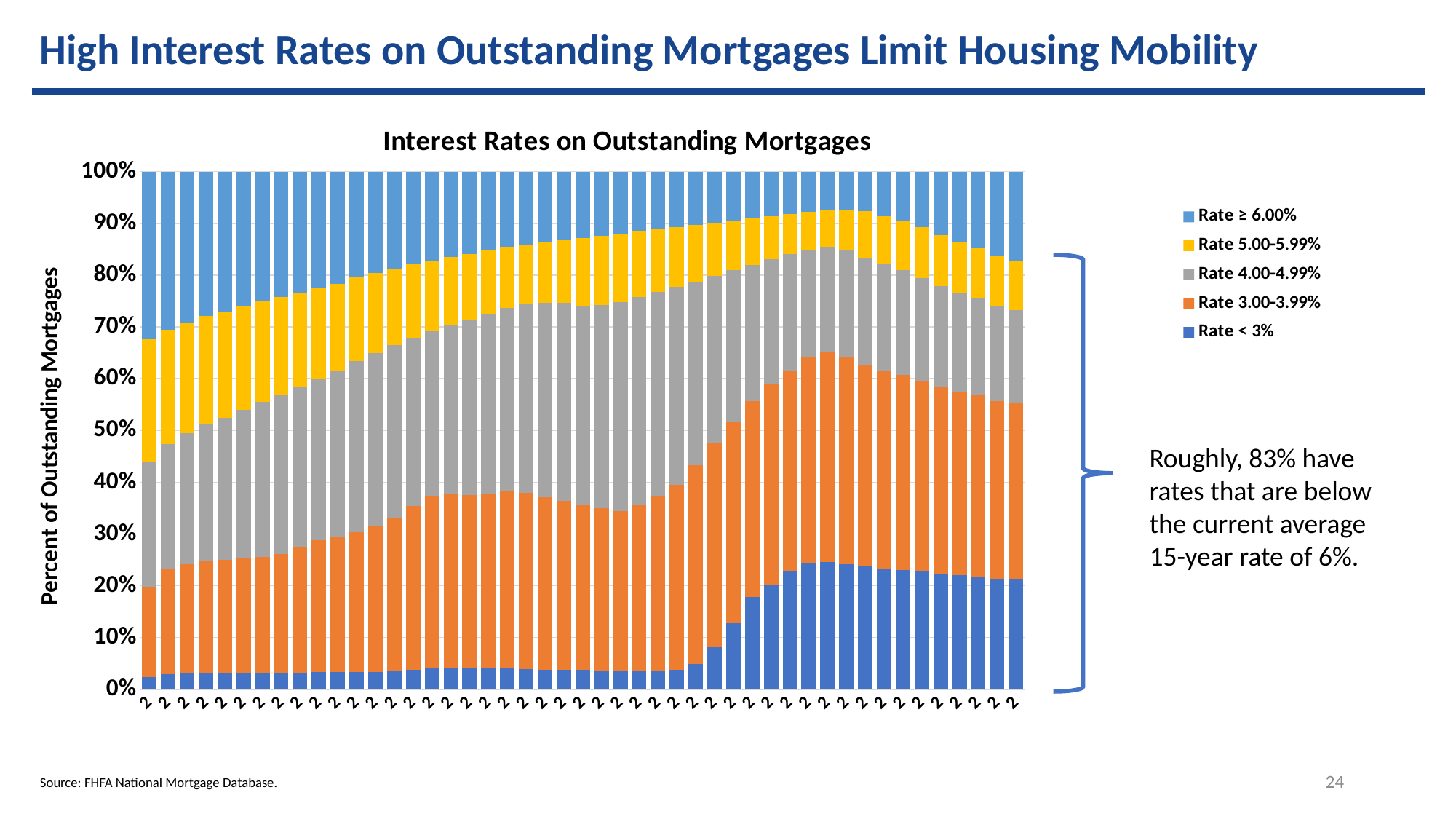
What is the title of the chart? Interest Rates on Outstanding Mortgages Does the share of mortgages with a rate below 3% (the dark blue segment) rise or fall from the left side of the chart to the right side? Rise In the leftmost bar, is the share for Rate ≥ 6.00% greater or less than 20%? greater In the rightmost bar, is the share for Rate < 3% greater or less than 10%? greater What is the label on the vertical axis of the chart? Percent of Outstanding Mortgages In the rightmost bar, which segment is larger: Rate 3.00-3.99% or Rate 5.00-5.99%? Rate 3.00-3.99% What kind of chart is shown on the slide? Stacked bar chart How many series does the legend of the chart list? 5 In the leftmost bar, which segment is larger: Rate ≥ 6.00% or Rate < 3%? Rate ≥ 6.00% Does the share of mortgages with a rate of 6.00% or higher (the light blue segment) rise or fall from the left side of the chart to the right side? Fall